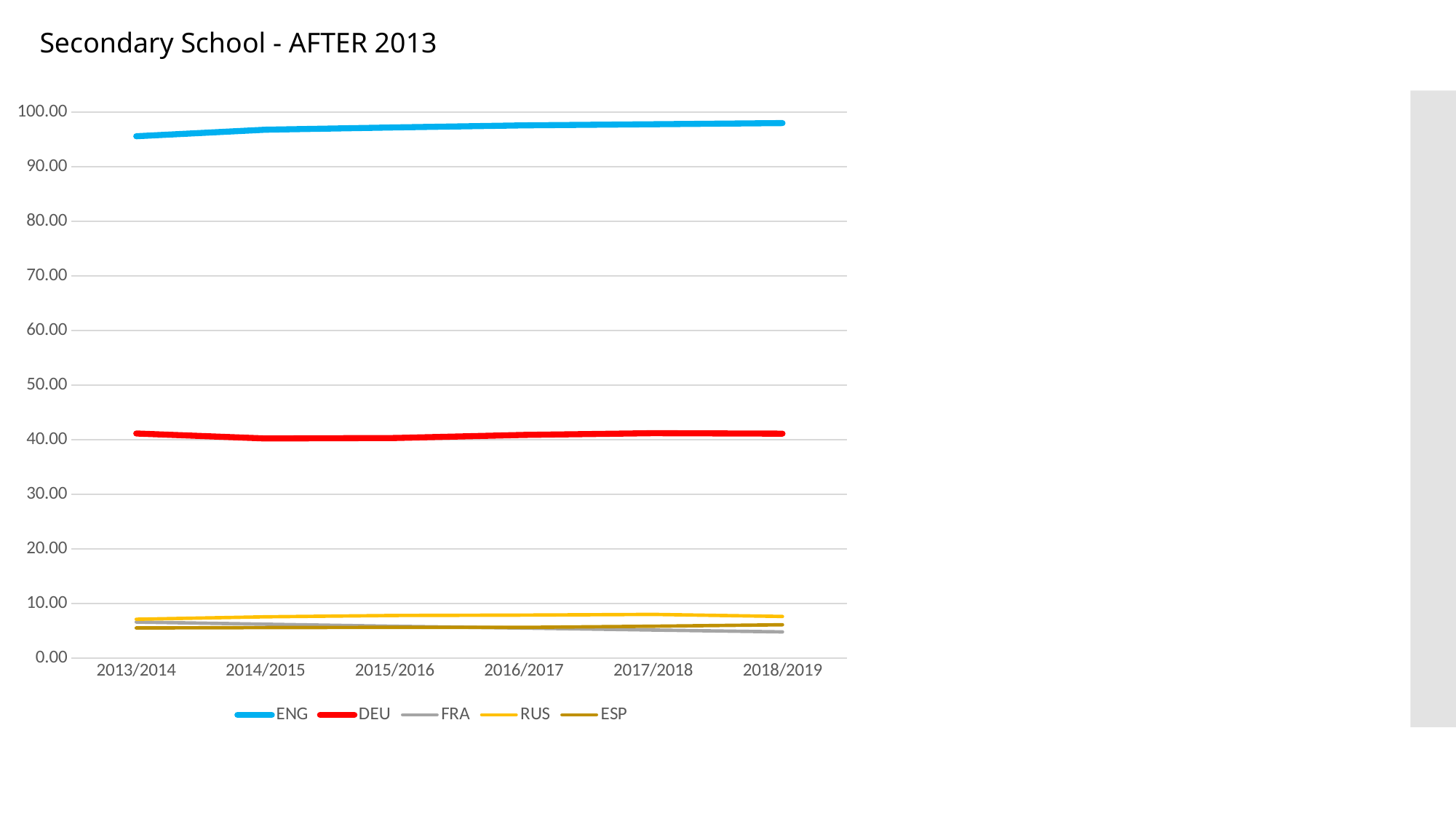
Which is larger in 2018/2019, the value for DEU or the value for RUS? DEU How many school years are shown on the x axis? 6 How many series does the legend list? 5 Does the ENG line rise or fall from 2013/2014 to 2018/2019? rise Which is larger in 2013/2014, the value for ENG or the value for DEU? ENG Is the value for DEU in 2018/2019 greater or less than 50? less Which series has the highest values across all years? ENG What is the title of the slide? Secondary School - AFTER 2013 Is the value for RUS in 2018/2019 greater or less than 10? less What kind of chart is shown on the slide? line chart Is the value for ENG in 2013/2014 greater or less than 90? greater Which series is drawn in red? DEU